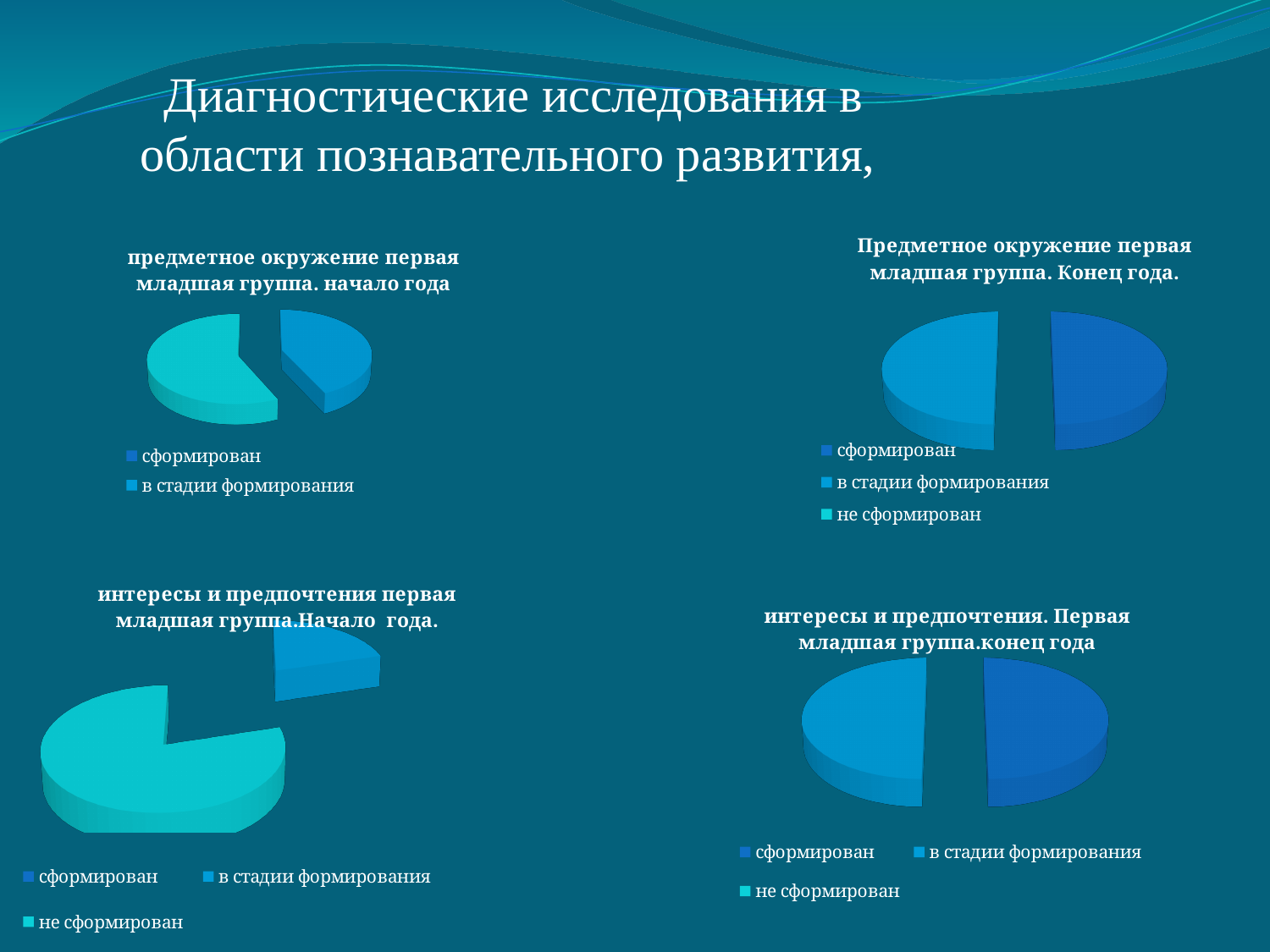
In the bottom-left chart "интересы и предпочтения первая младшая группа.Начало года.", which slice is larger: "сформирован" or "в стадии формирования"? в стадии формирования What kind of chart is the bottom-left chart "интересы и предпочтения первая младшая группа.Начало года."? pie chart What is the title of the top-right chart on the slide? Предметное окружение первая младшая группа. Конец года. In the top-left chart "предметное окружение первая младшая группа. начало года", which slice is larger: "сформирован" or "в стадии формирования"? в стадии формирования In the bottom-left chart "интересы и предпочтения первая младшая группа.Начало года.", which category has the smallest visible slice? в стадии формирования How many legend entries does the bottom-left chart "интересы и предпочтения первая младшая группа.Начало года." list? 3 How many pie charts are shown on the slide? 4 How many legend entries does the bottom-right chart "интересы и предпочтения. Первая младшая группа.конец года" list? 3 How many legend entries does the top-right chart "Предметное окружение первая младшая группа. Конец года." list? 3 What kind of chart is the top-left chart titled "предметное окружение первая младшая группа. начало года"? pie chart